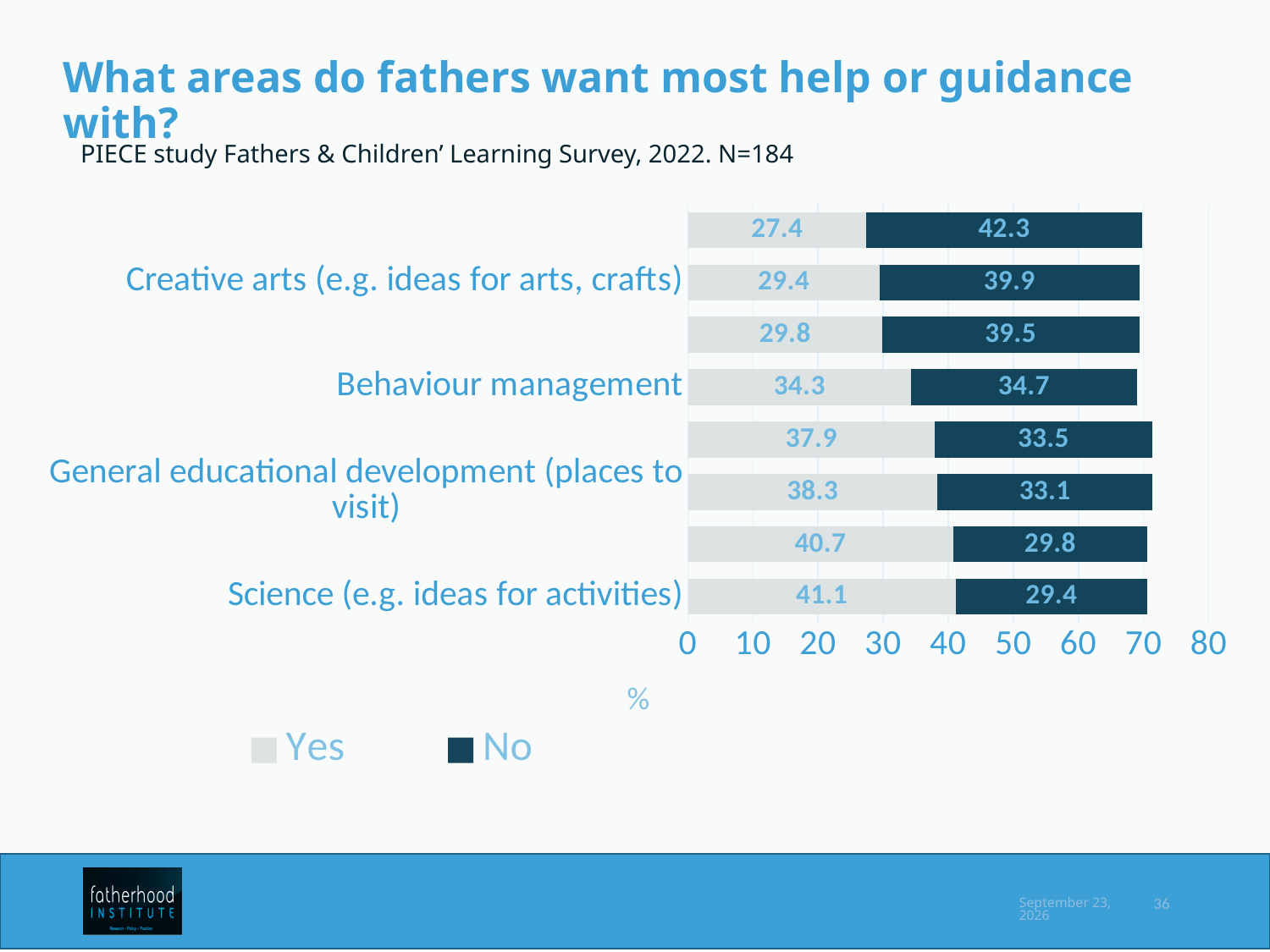
What is the No value for General educational development (places to visit)? 33.1 How many bars are plotted in the chart? 8 What is the Yes value for Science (e.g. ideas for activities)? 41.1 Is the total of the stacked bar for Creative arts (e.g. ideas for arts, crafts) greater or less than 60? greater What is the No value for Creative arts (e.g. ideas for arts, crafts)? 39.9 For Creative arts (e.g. ideas for arts, crafts), which is larger, the Yes value or the No value? No What is the total of the stacked bar for Science (e.g. ideas for activities)? 70.5 What is the difference between the Yes and No values for Science (e.g. ideas for activities)? 11.7 What kind of chart is shown on the slide? Stacked horizontal bar chart Which category has the highest Yes value? Science (e.g. ideas for activities) How many series does the legend list? 2 What is the Yes value for Behaviour management? 34.3